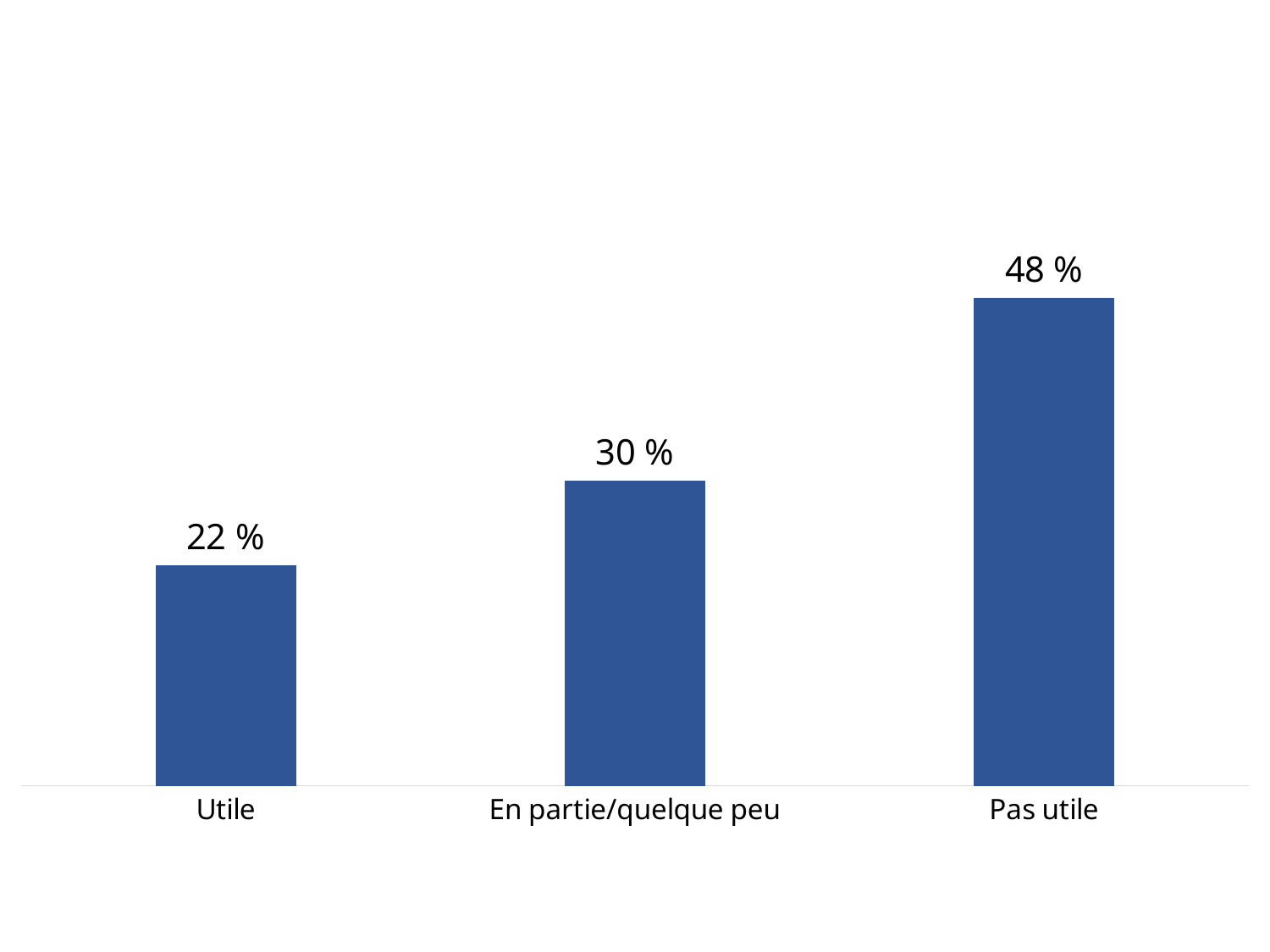
Which is larger, the value for "En partie/quelque peu" or the value for "Pas utile"? Pas utile Which category has the lowest value? Utile What is the difference between the values for "En partie/quelque peu" and "Utile"? 8 % Do the values rise or fall from left to right along the x axis? Rise What is the value for "Pas utile"? 48 % What is the value for "En partie/quelque peu"? 30 % What kind of chart is shown on the slide? Bar chart What colour are the bars on the chart? Blue How many categories are shown on the chart? 3 What is the difference between the values for "Pas utile" and "Utile"? 26 % Which category has the highest value? Pas utile What is the value for "Utile"? 22 %